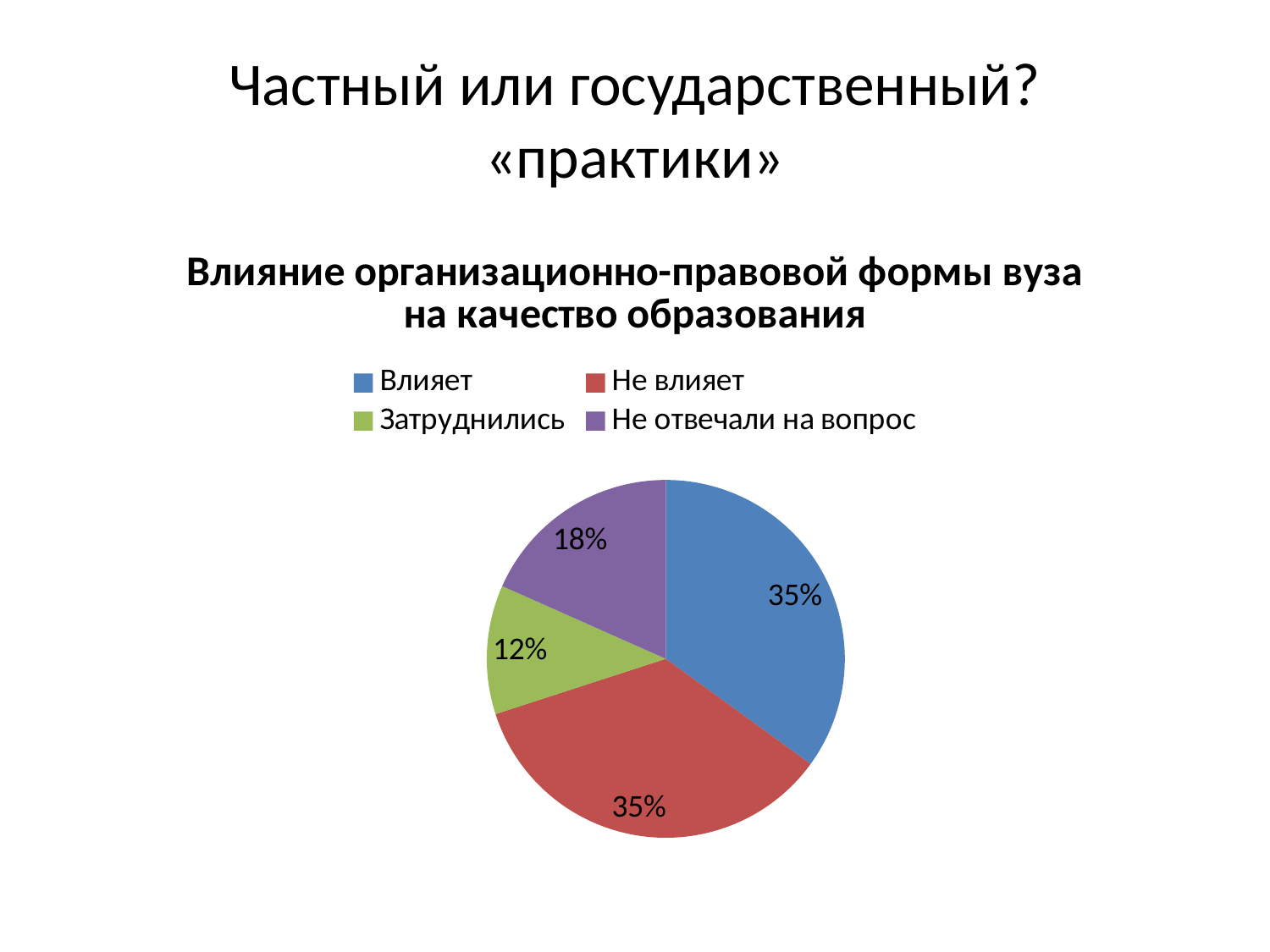
How many entries does the legend list? 4 What share of the pie is labelled "Затруднились"? 12% What is the title of the chart? Влияние организационно-правовой формы вуза на качество образования What share of the pie is labelled "Не влияет"? 35% How many slices does the pie chart have? 4 What kind of chart is shown on the slide? pie chart Which category has the smallest slice of the pie? Затруднились What colour is the slice for "Не влияет"? red What is the difference in percentage points between the "Влияет" slice and the "Затруднились" slice? 23 Which is larger: the slice for "Не отвечали на вопрос" or the slice for "Затруднились"? Не отвечали на вопрос What share of the pie is labelled "Не отвечали на вопрос"? 18% What share of the pie is labelled "Влияет"? 35%